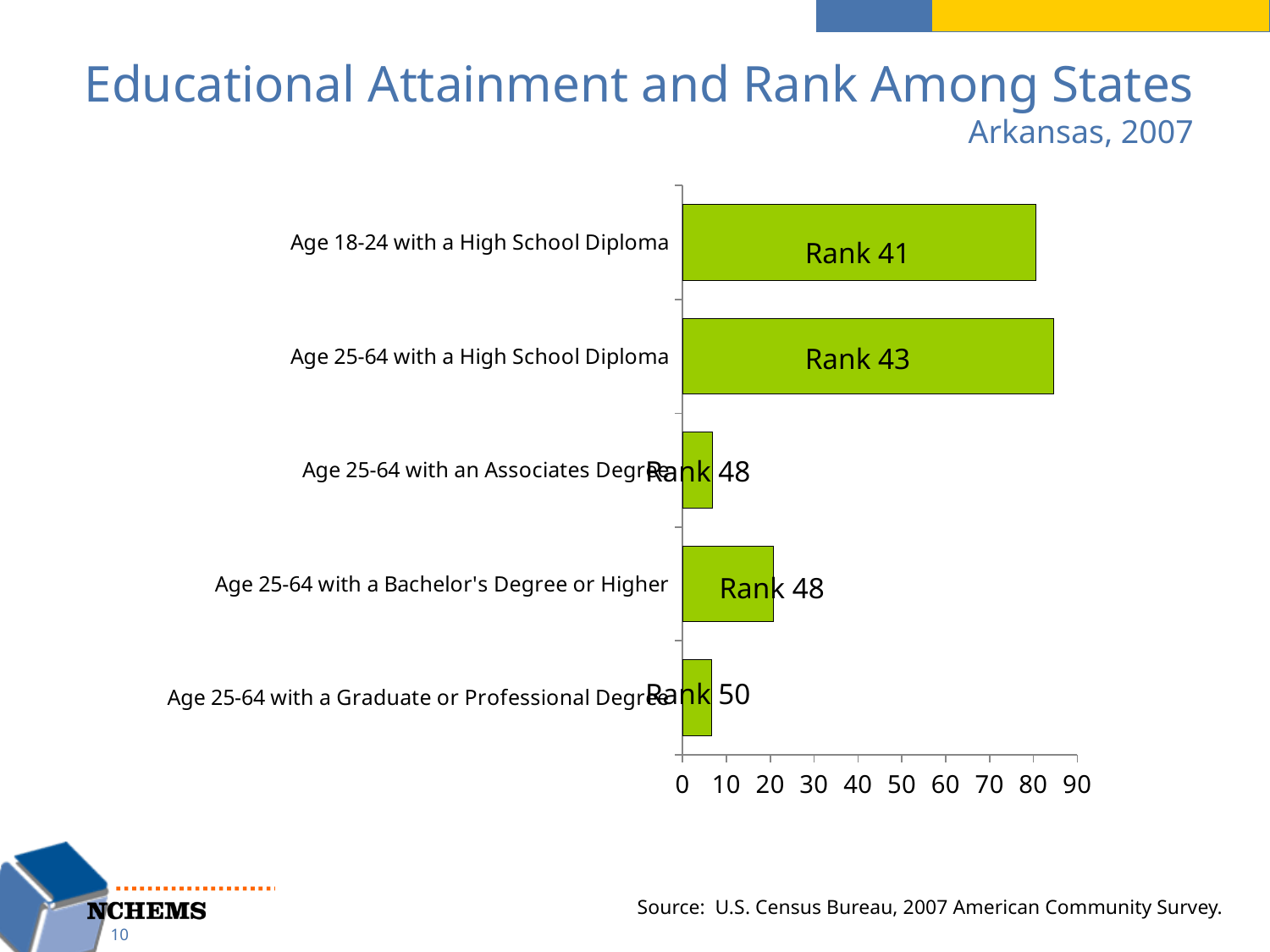
Is the value for Age 25-64 with a Bachelor's Degree or Higher greater or less than 30? less What rank is shown for Age 25-64 with a Bachelor's Degree or Higher? Rank 48 What rank is shown for Age 25-64 with a Graduate or Professional Degree? Rank 50 What kind of chart is shown on the slide? bar chart Is the value for Age 25-64 with an Associates Degree greater or less than 10? less What rank is shown for Age 25-64 with a High School Diploma? Rank 43 Is the value for Age 18-24 with a High School Diploma greater or less than 70? greater How many categories are plotted in the chart? 5 Which category has the longest bar? Age 25-64 with a High School Diploma What rank is shown for Age 18-24 with a High School Diploma? Rank 41 Which state and year does the chart cover, according to the subtitle? Arkansas, 2007 Which is larger, the value for Age 25-64 with a Bachelor's Degree or Higher or the value for Age 25-64 with an Associates Degree? Age 25-64 with a Bachelor's Degree or Higher